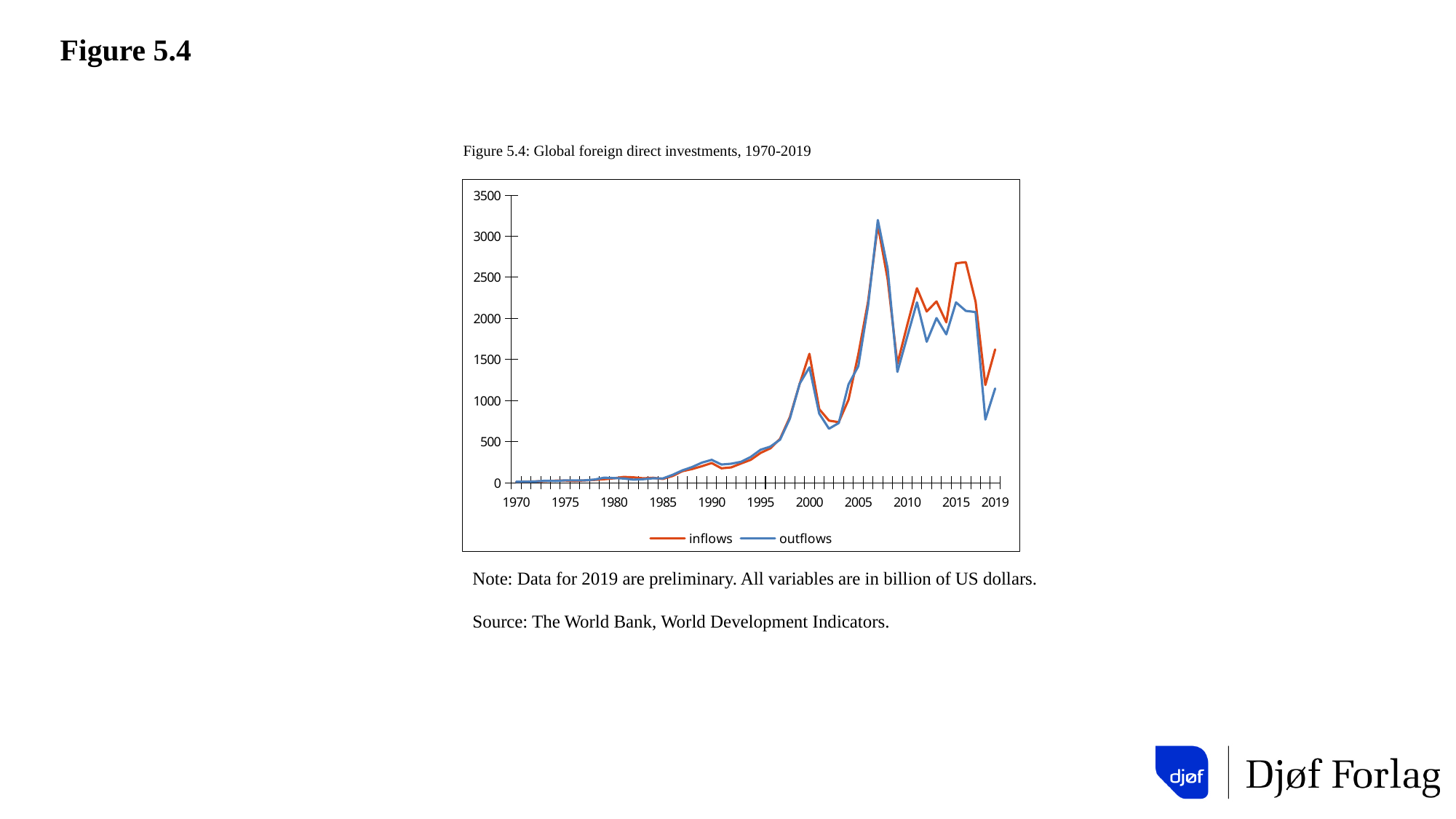
In 2018, which series has the larger value, inflows or outflows? inflows In 2015, which series has the larger value, inflows or outflows? inflows Which colour is used for the outflows series? blue How many series does the legend list? 2 Is the value for inflows in 2000 greater or less than 1000? greater Is the value for inflows in 1990 greater or less than 500? less In which year do inflows reach their highest value? 2007 What kind of chart is shown on the slide? line chart Is the value for outflows in 2018 greater or less than 1000? less What is the title of the chart? Figure 5.4: Global foreign direct investments, 1970-2019 Do the inflows generally rise or fall between 1970 and 2007? rise